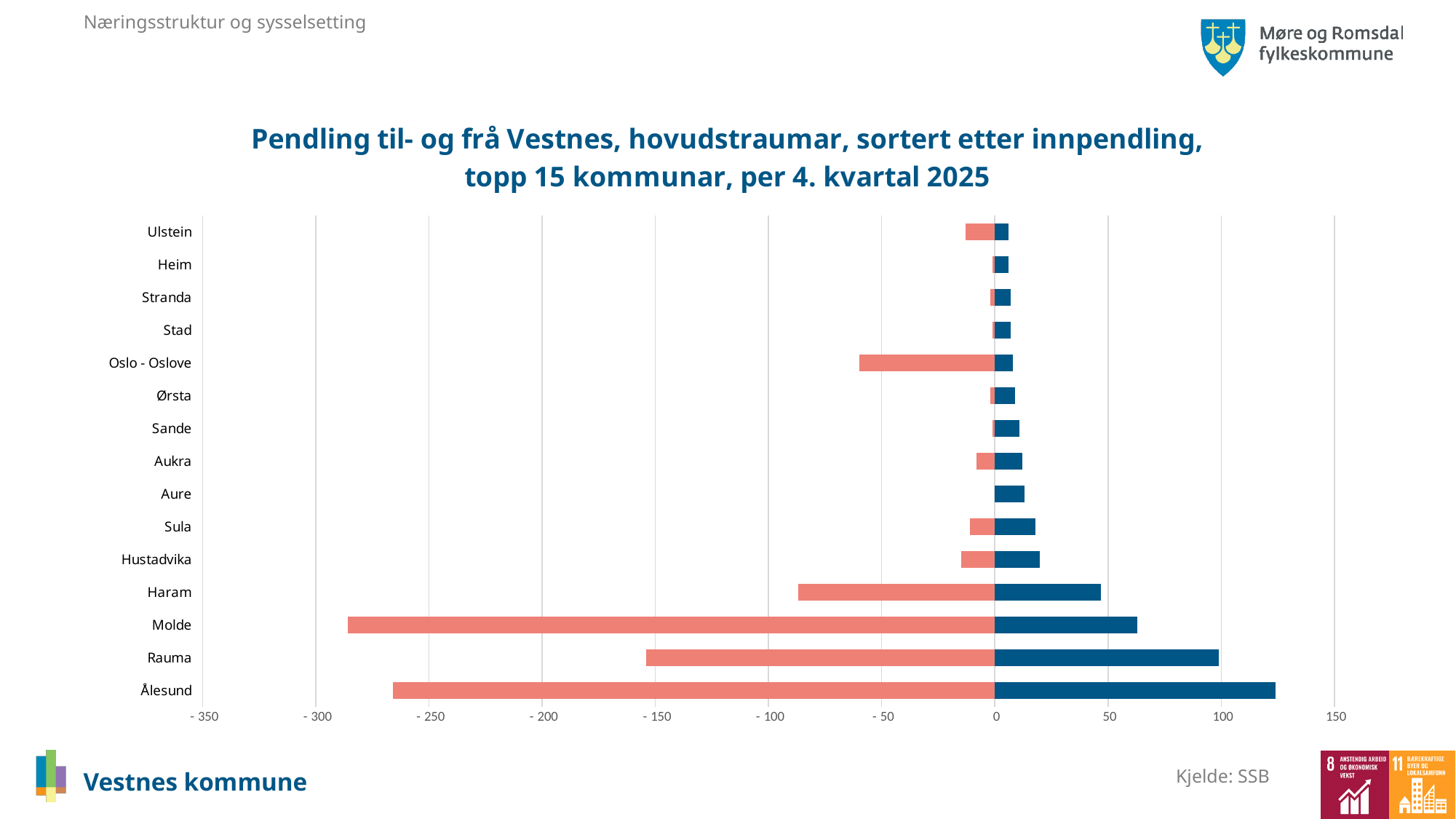
Is the blue bar value for Molde greater or less than 50? greater Which has the larger blue bar, Ålesund or Rauma? Ålesund Which municipality has the longest red bar (most negative value) in the chart? Molde What source is cited for the chart data on the slide? SSB Which municipality has the longest blue bar (largest positive value) in the chart? Ålesund Which has the longer red bar, Haram or Oslo - Oslove? Haram Is the red bar value for Oslo - Oslove greater or less than -50? less What kind of chart is shown on the slide? bar chart Is the red bar value for Molde greater or less than -250? less How many municipalities (categories) are listed on the vertical axis of the chart? 15